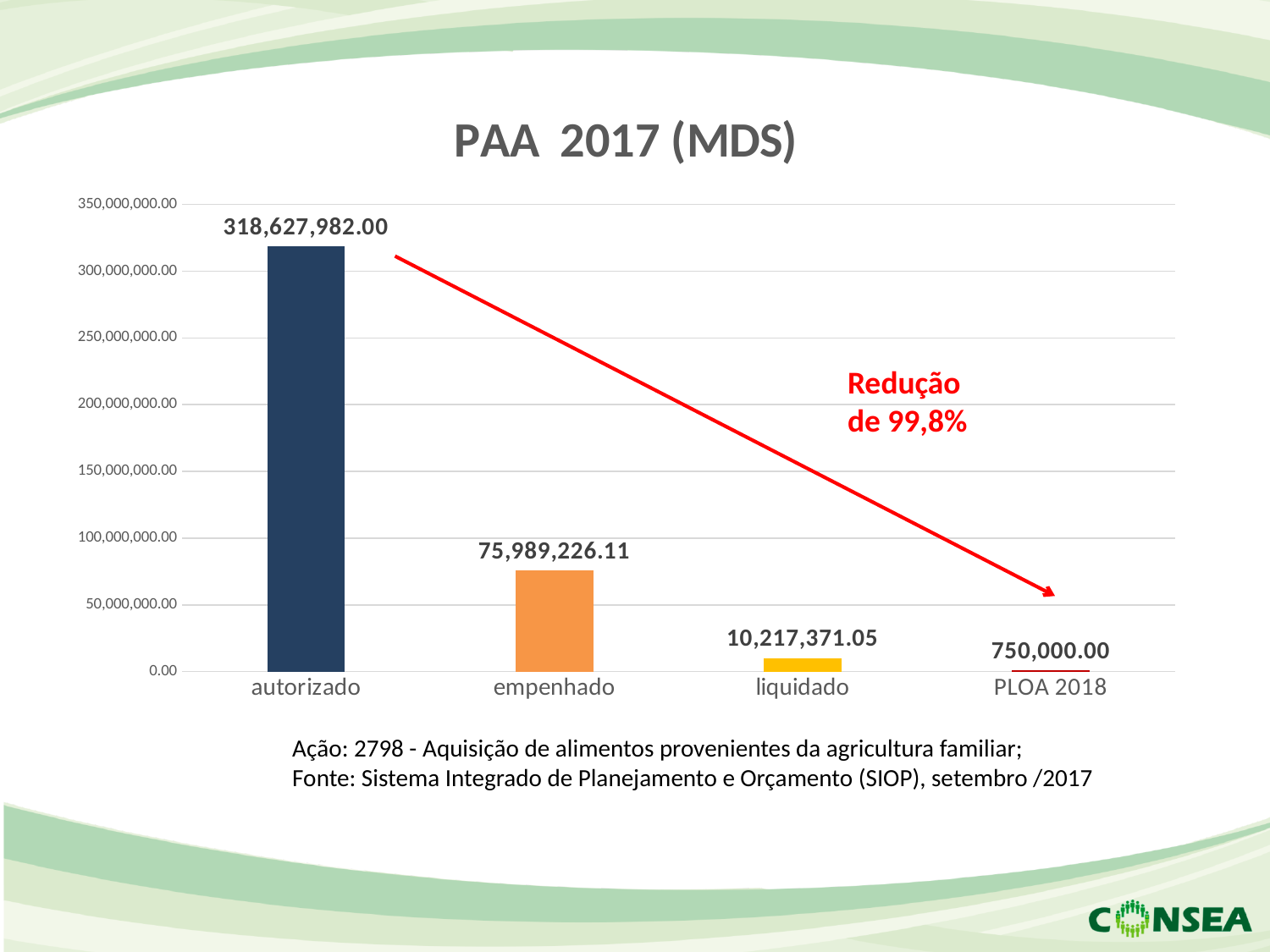
Is the value for empenhado greater or less than 100,000,000.00? less Which category has the lowest value? PLOA 2018 What is the difference between the values for empenhado and liquidado? 65,771,855.06 What is the value for empenhado? 75,989,226.11 What kind of chart is shown on the slide? bar chart What is the value for autorizado? 318,627,982.00 How many categories are shown on the x axis? 4 Which category has the highest value? autorizado Which is larger, the value for liquidado or the value for PLOA 2018? liquidado What is the difference between the values for autorizado and empenhado? 242,638,755.89 What is the value for liquidado? 10,217,371.05 What is the value for PLOA 2018? 750,000.00